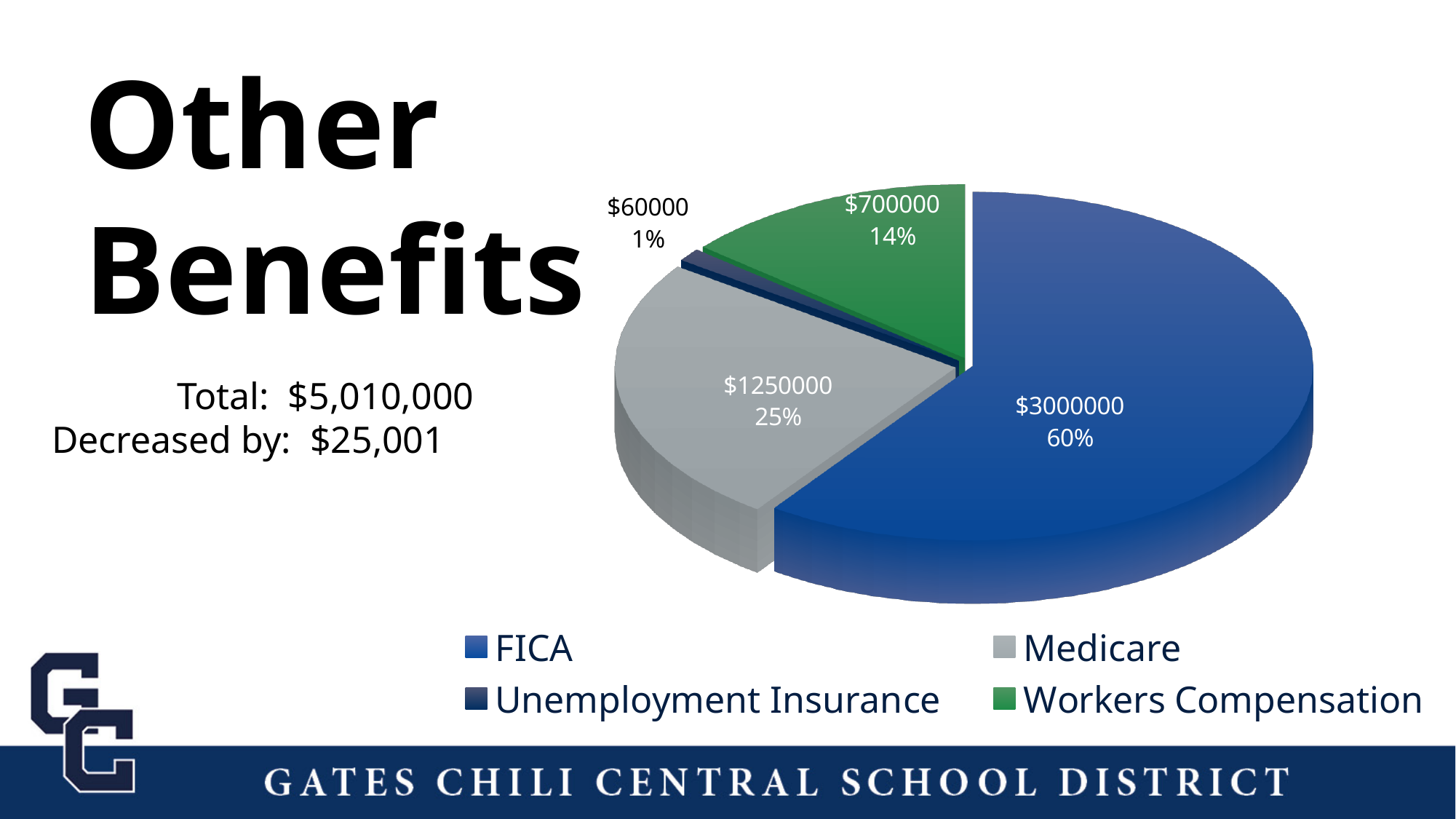
What share of the pie does Workers Compensation represent? 14% What kind of chart is shown on the slide? Pie chart Which category has the largest slice of the pie? FICA What is the value for Workers Compensation? $700000 What is the value for Unemployment Insurance? $60000 Which is larger, the value for Workers Compensation or the value for Unemployment Insurance? Workers Compensation What share of the pie does Medicare represent? 25% What is the value for FICA? $3000000 What is the difference between the FICA value and the Medicare value? $1750000 How many categories are shown in the pie chart? 4 What is the value for Medicare? $1250000 Which category has the smallest slice of the pie? Unemployment Insurance